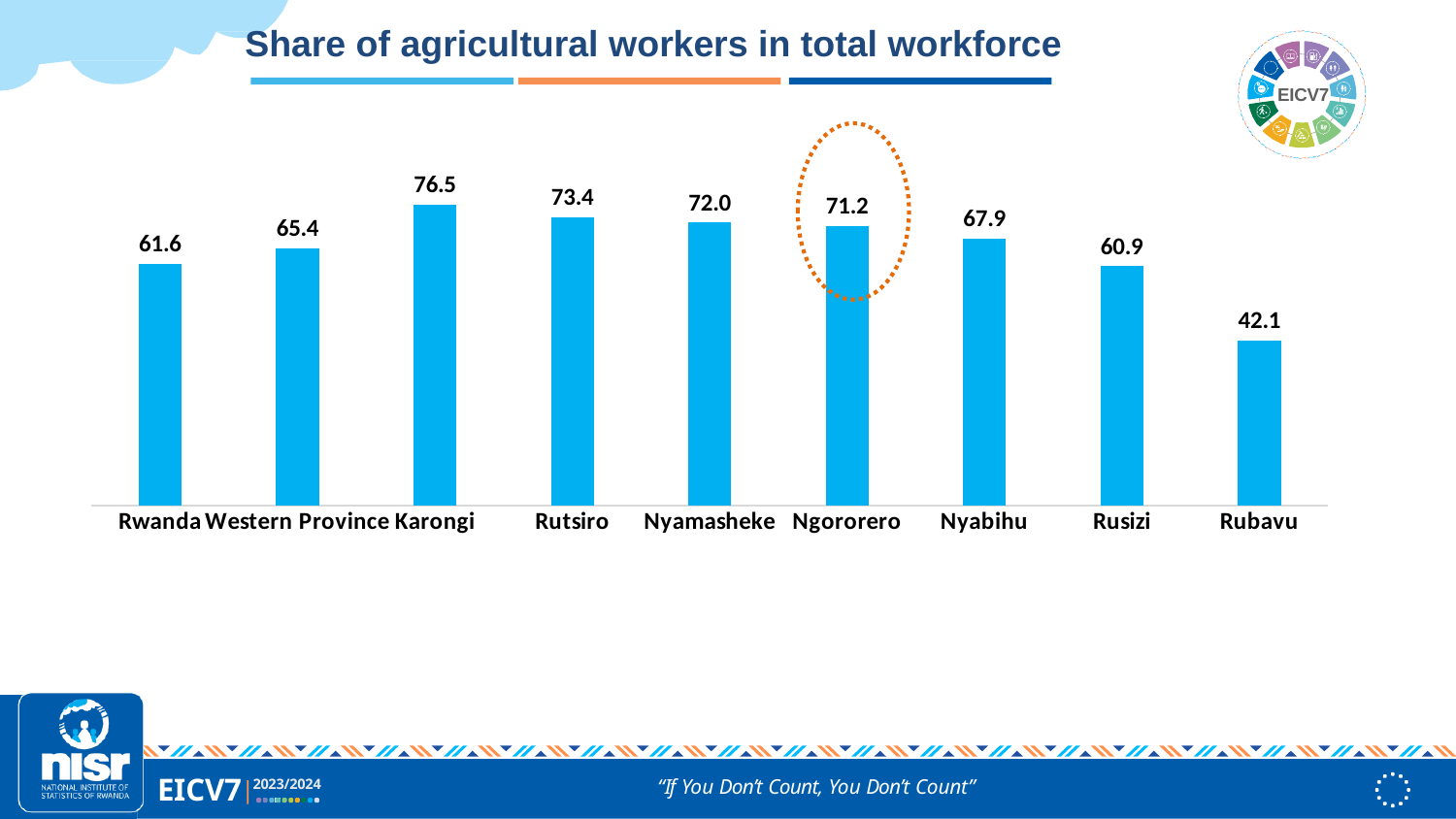
Which category has the lowest share of agricultural workers? Rubavu What is the value shown for Western Province? 65.4 What kind of chart is shown on the slide? Bar chart What is the difference between the values for Karongi and Rubavu? 34.4 What is the share of agricultural workers in total workforce for Karongi? 76.5 Which category has the highest share of agricultural workers? Karongi How many categories are shown on the x axis? 9 Which category is highlighted with a dashed orange circle? Ngororero Which has a larger value, Rutsiro or Nyabihu? Rutsiro What is the difference between the values for Western Province and Rwanda? 3.8 What is the value shown for Ngororero? 71.2 What is the value shown for Rubavu? 42.1